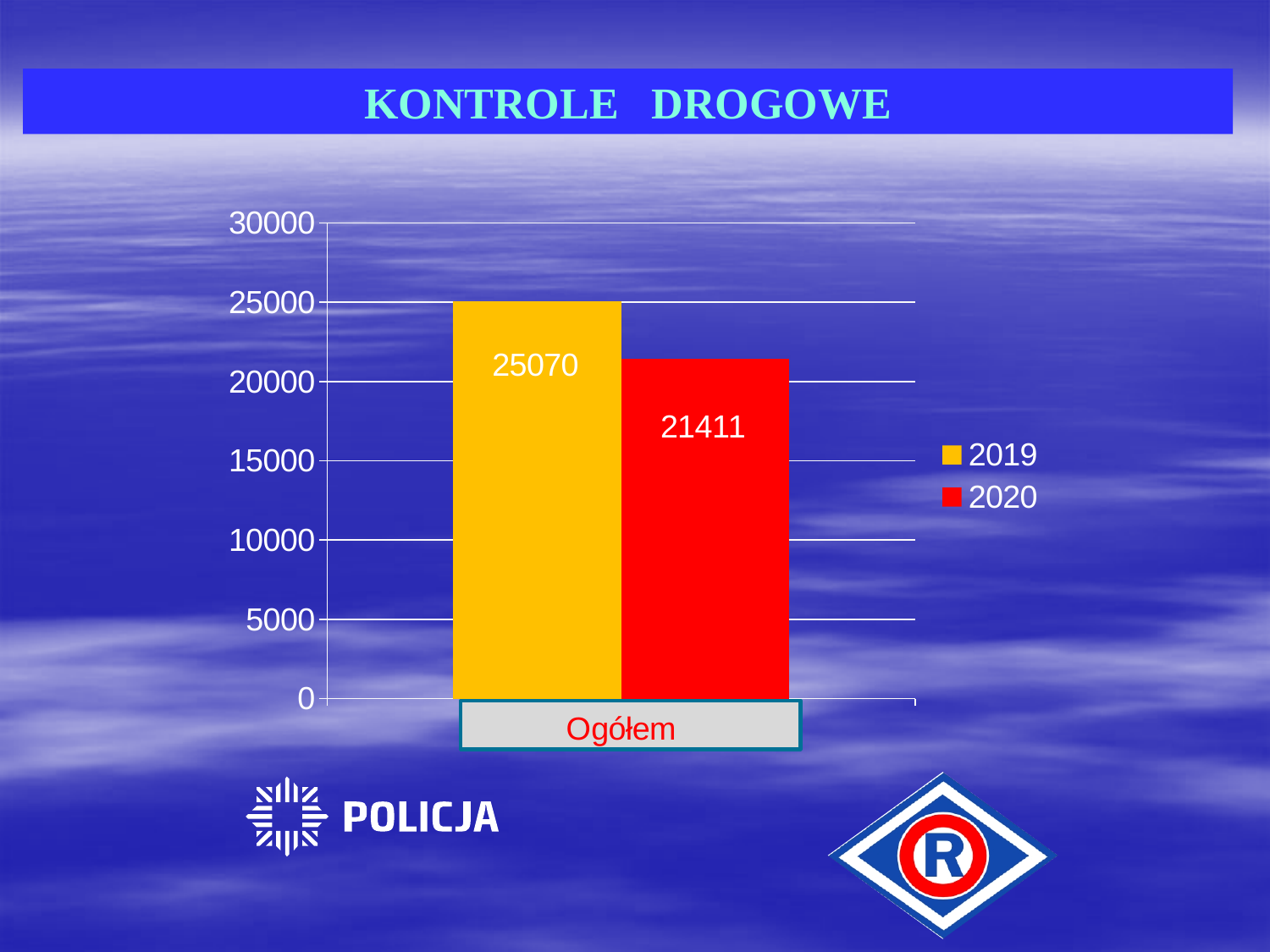
How many categories are shown on the x axis? 1 Is the value for 2019 greater or less than 25000? greater What is the value for 2020 in the Ogółem category? 21411 What kind of chart is shown on the slide? bar chart What colour is the bar for 2020? red How many series does the legend list? 2 What is the title of the slide? KONTROLE DROGOWE Which series has the higher value for Ogółem, 2019 or 2020? 2019 What is the value for 2019 in the Ogółem category? 25070 Which series has the lowest value on the chart? 2020 What is the difference between the 2019 and 2020 values for Ogółem? 3659 Is the value for 2020 greater or less than 25000? less